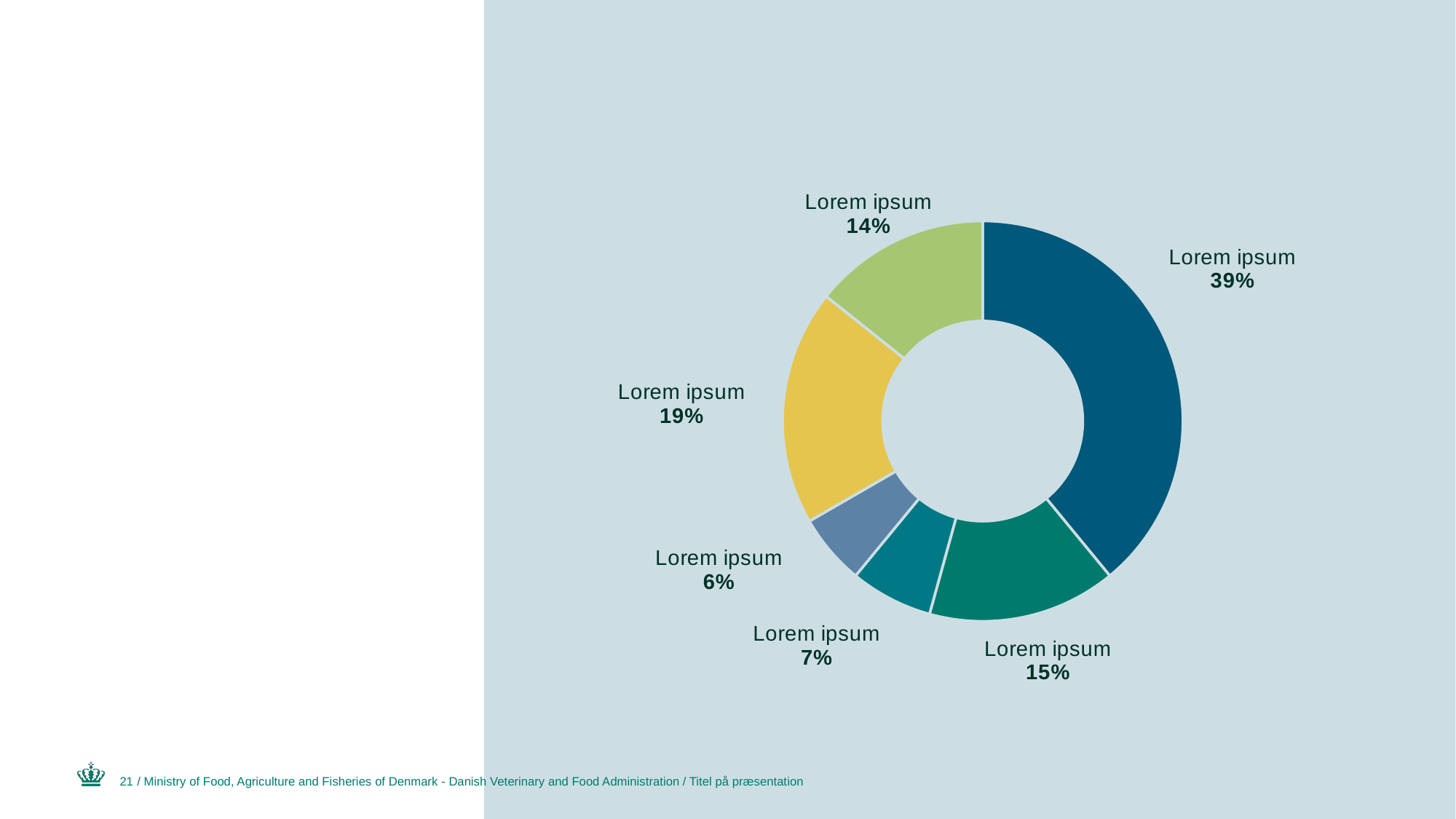
What percentage is shown for the dark blue slice on the right of the doughnut chart? 39% What label text is used for every slice of the doughnut chart? Lorem ipsum What percentage is shown for the green slice at the bottom of the doughnut chart? 15% What is the difference between the largest slice (39%) and the yellow slice (19%)? 20% What is the largest share shown in the doughnut chart? 39% What percentage is shown for the light green slice at the top of the doughnut chart? 14% What is the combined share of the two smallest slices, 7% and 6%? 13% How many slices does the doughnut chart have? 6 What kind of chart is shown on the slide? Doughnut chart Which is larger, the slice labelled 15% or the slice labelled 14%? 15% What is the smallest share shown in the doughnut chart? 6% What percentage is shown for the yellow slice on the left of the doughnut chart? 19%